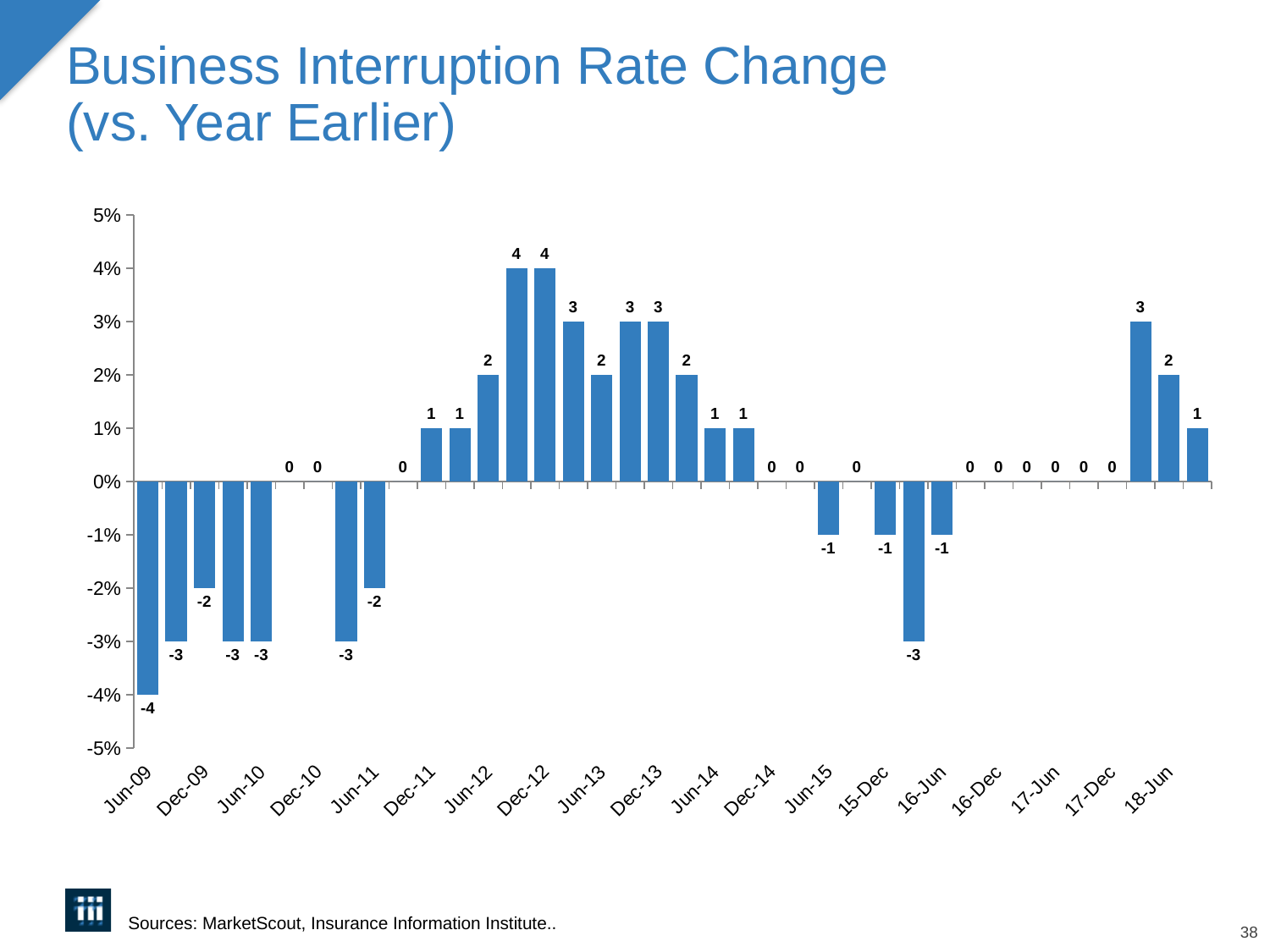
How many bars in the chart have a data label of 4? 2 What is the highest value shown by any bar in the chart? 4 Do the bar values generally rise or fall from Jun-09 to Dec-12? rise What is the title of the chart? Business Interruption Rate Change (vs. Year Earlier) What is the value of the first bar, labelled Jun-09? -4 Is the value for Jun-09 greater or less than -3%? less What kind of chart is shown on the slide? bar chart What is the lowest value shown by any bar in the chart? -4 How many bars in the chart have a data label of -3? 5 Which is larger, the value of the first bar (Jun-09) or the value of the last bar in the chart? the last bar What is the maximum value shown on the vertical axis? 5% What is the difference between the highest bar value (4) and the lowest bar value (-4)? 8